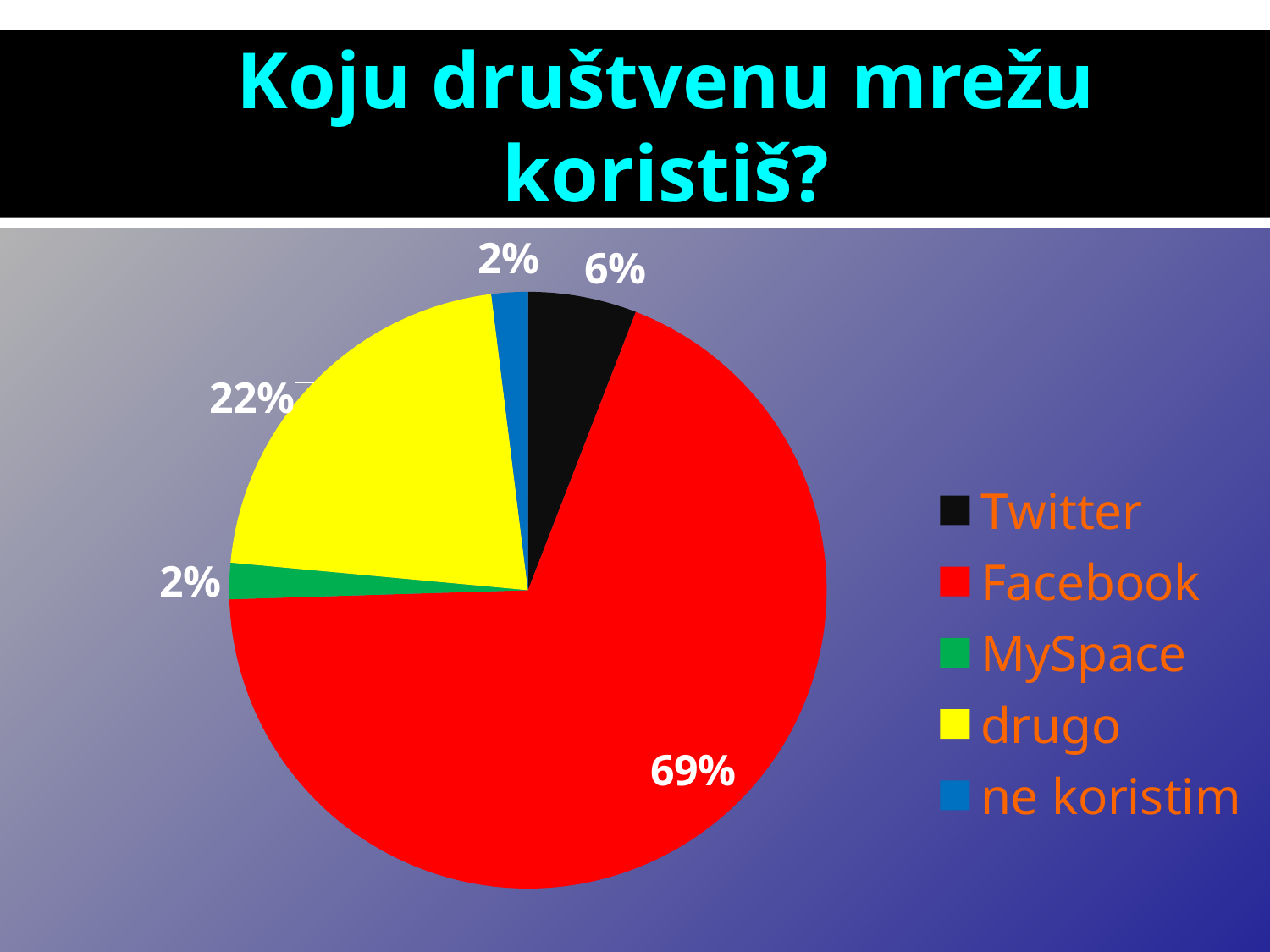
What is the difference in percentage points between drugo and Twitter? 16 How many categories does the pie chart show? 5 What share of the pie does MySpace have? 2% What is the difference in percentage points between Facebook and drugo? 47 What colour is the slice for drugo? yellow What share of the pie does Facebook have? 69% Which is larger, the slice for Twitter or the slice for drugo? drugo What share of the pie does Twitter have? 6% Which category has the largest slice of the pie? Facebook What kind of chart is shown on the slide? pie chart